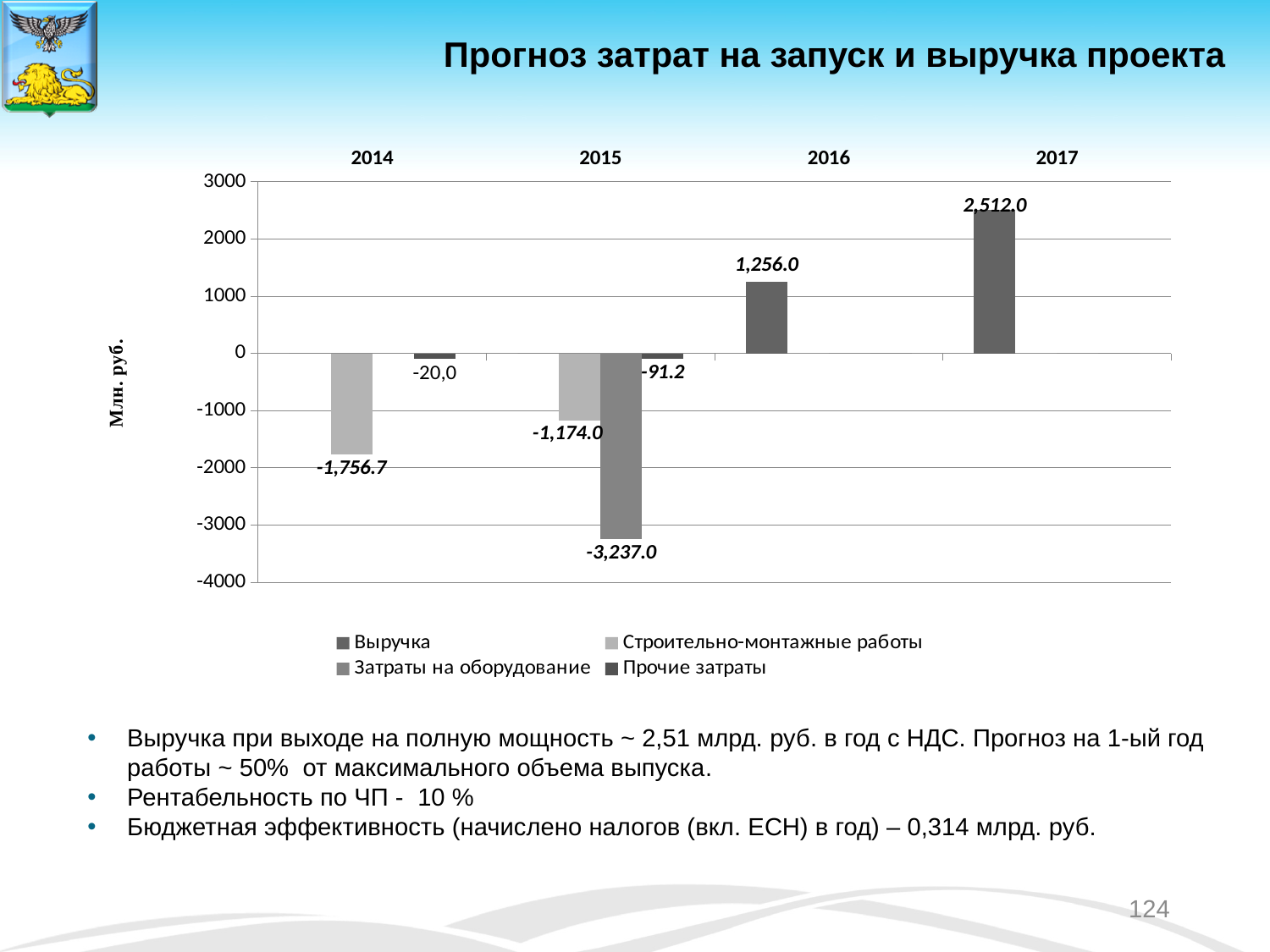
How many series does the legend list? 4 What is the value of Строительно-монтажные работы for 2014? -1,756.7 What is the value of Выручка for 2016? 1,256.0 How many years are shown on the x axis? 4 Is the value of Выручка for 2017 greater or less than 2000? greater What is the value of Затраты на оборудование for 2015? -3,237.0 What is the value of Выручка for 2017? 2,512.0 What is the value of Прочие затраты for 2015? -91.2 In which year is the lowest (most negative) value on the chart? 2015 Which year has the lower value for Строительно-монтажные работы, 2014 or 2015? 2014 What is the difference between Выручка in 2017 and Выручка in 2016? 1,256.0 What kind of chart is shown on the slide? bar chart